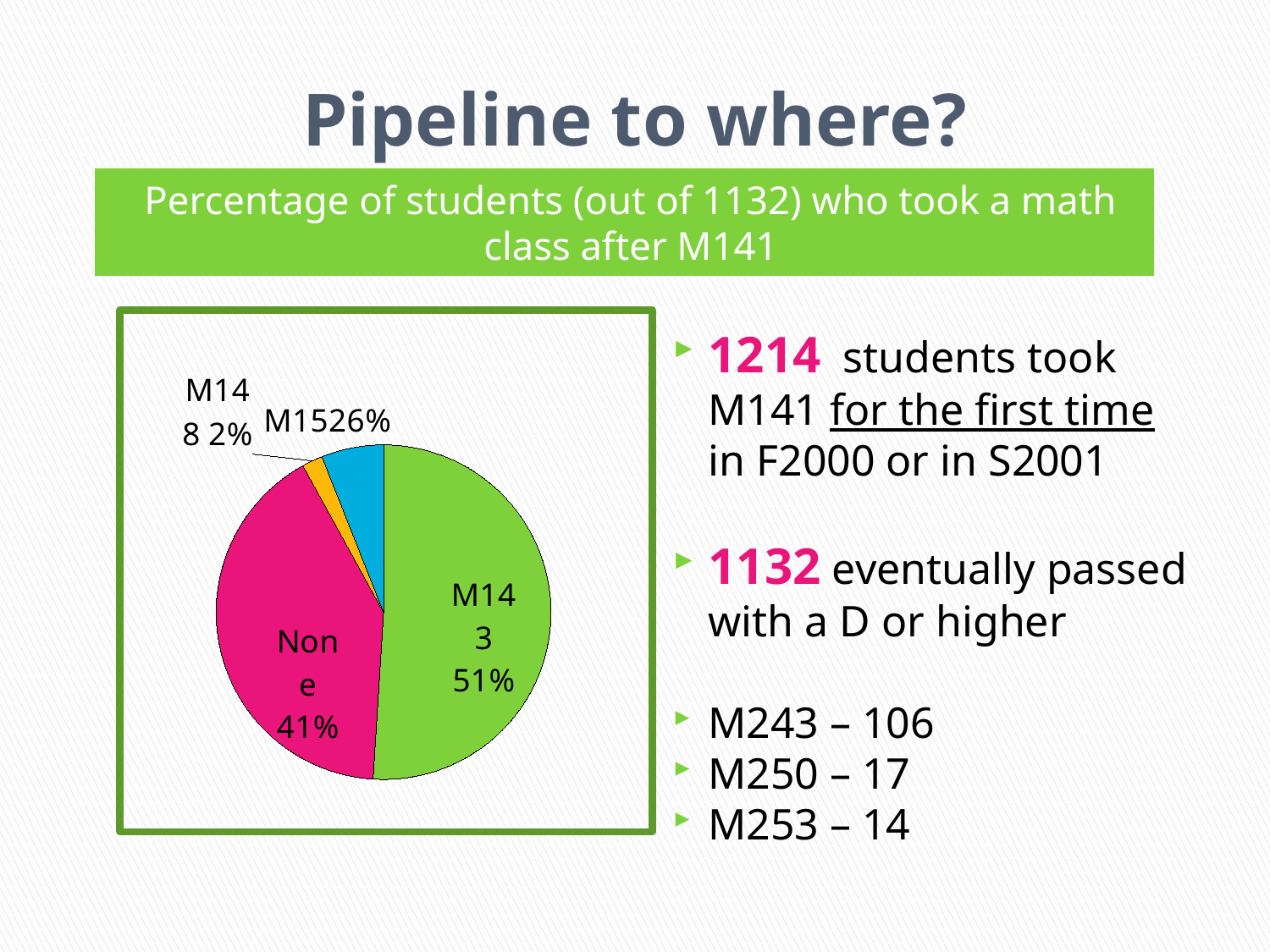
Which category has the smallest slice of the pie? M148 What percentage of students took M148 after M141? 2% What percentage of students took no math class (None) after M141? 41% What is the title shown above the pie chart? Percentage of students (out of 1132) who took a math class after M141 What percentage of students took M143 after M141? 51% How many slices does the pie chart have? 4 Which is larger, the share for M143 or the share for None? M143 What colour is the M143 slice of the pie? green What is the difference between the M143 share and the None share? 10% What kind of chart is shown on the slide? pie chart What is the combined share of the M143 and None slices? 92% Which category has the largest slice of the pie? M143